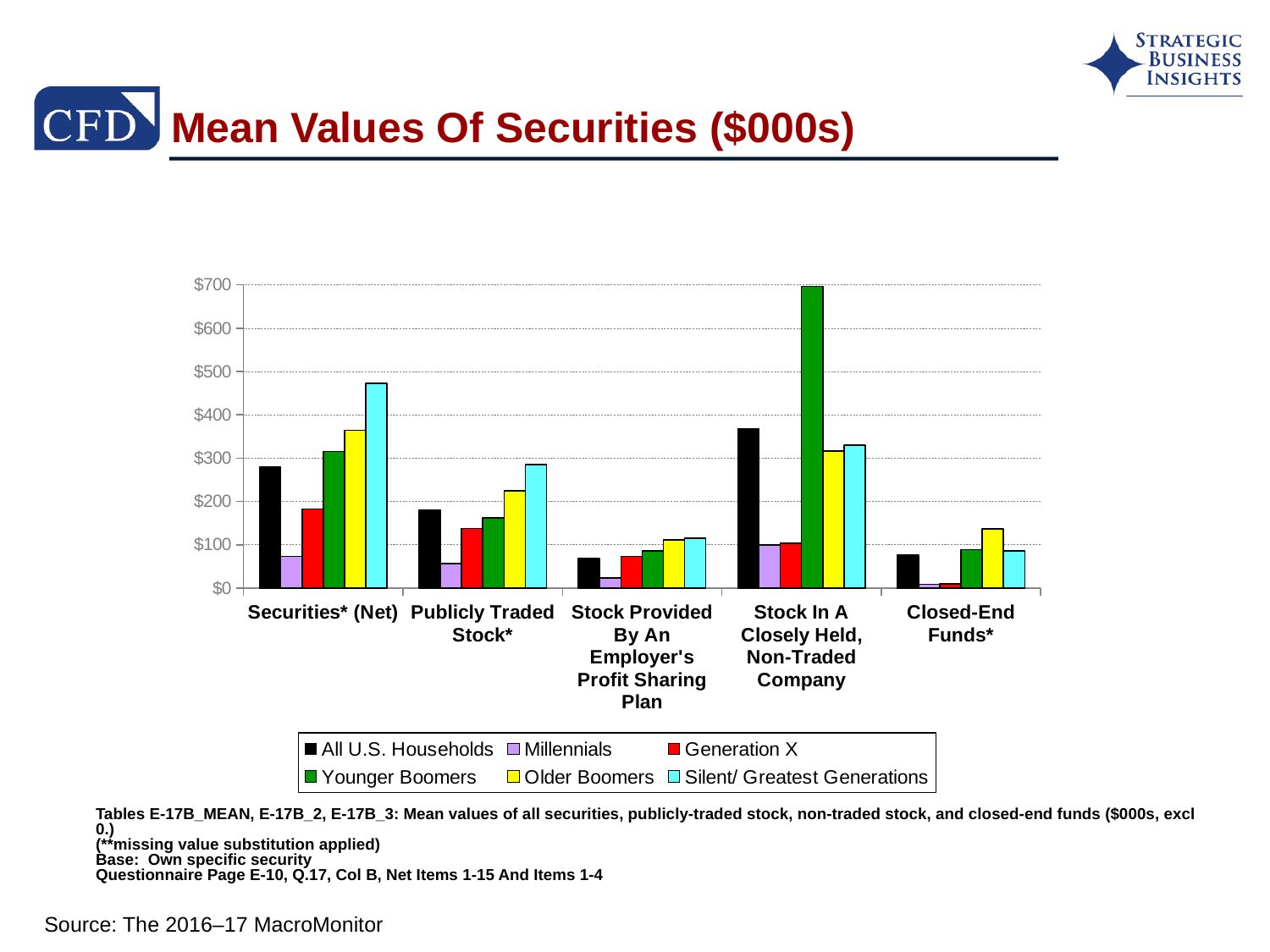
Which series has the highest value for Stock In A Closely Held, Non-Traded Company? Younger Boomers Which series has the highest value for Securities* (Net)? Silent/ Greatest Generations Is the value for Silent/ Greatest Generations in Securities* (Net) greater or less than $400? greater How many series does the legend list? 6 What is the title of the chart? Mean Values Of Securities ($000s) In which category is the Millennials value the lowest? Closed-End Funds* For Publicly Traded Stock*, which is larger: Older Boomers or Younger Boomers? Older Boomers How many security categories are shown along the x axis? 5 What kind of chart is shown on the slide? bar chart Is the value for All U.S. Households in Publicly Traded Stock* greater or less than $100? greater Which series has the lowest value for Securities* (Net)? Millennials Is the value for Younger Boomers in Stock In A Closely Held, Non-Traded Company greater or less than $600? greater